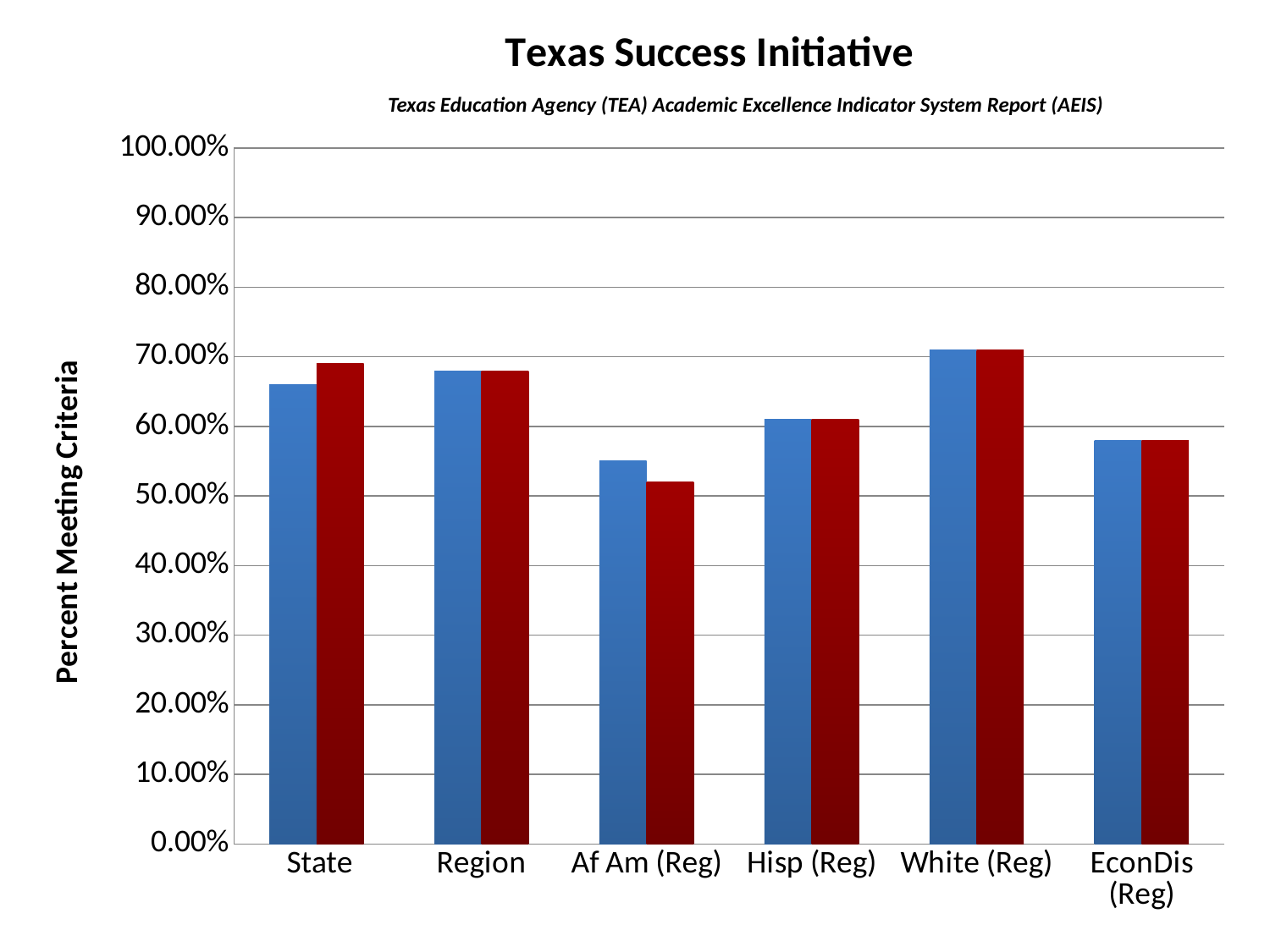
What is the label on the y axis? Percent Meeting Criteria Which category has the lowest bars? Af Am (Reg) For State, which bar is taller, the blue bar or the red bar? the red bar What is the title of the chart? Texas Success Initiative Is the blue bar for State greater or less than 60.00%? greater How many categories are shown on the x axis? 6 Which category has the highest bars? White (Reg) Is the blue bar for White (Reg) greater or less than 60.00%? greater What kind of chart is shown on the slide? bar chart Is the red bar for Af Am (Reg) greater or less than 60.00%? less For Af Am (Reg), which bar is taller, the blue bar or the red bar? the blue bar